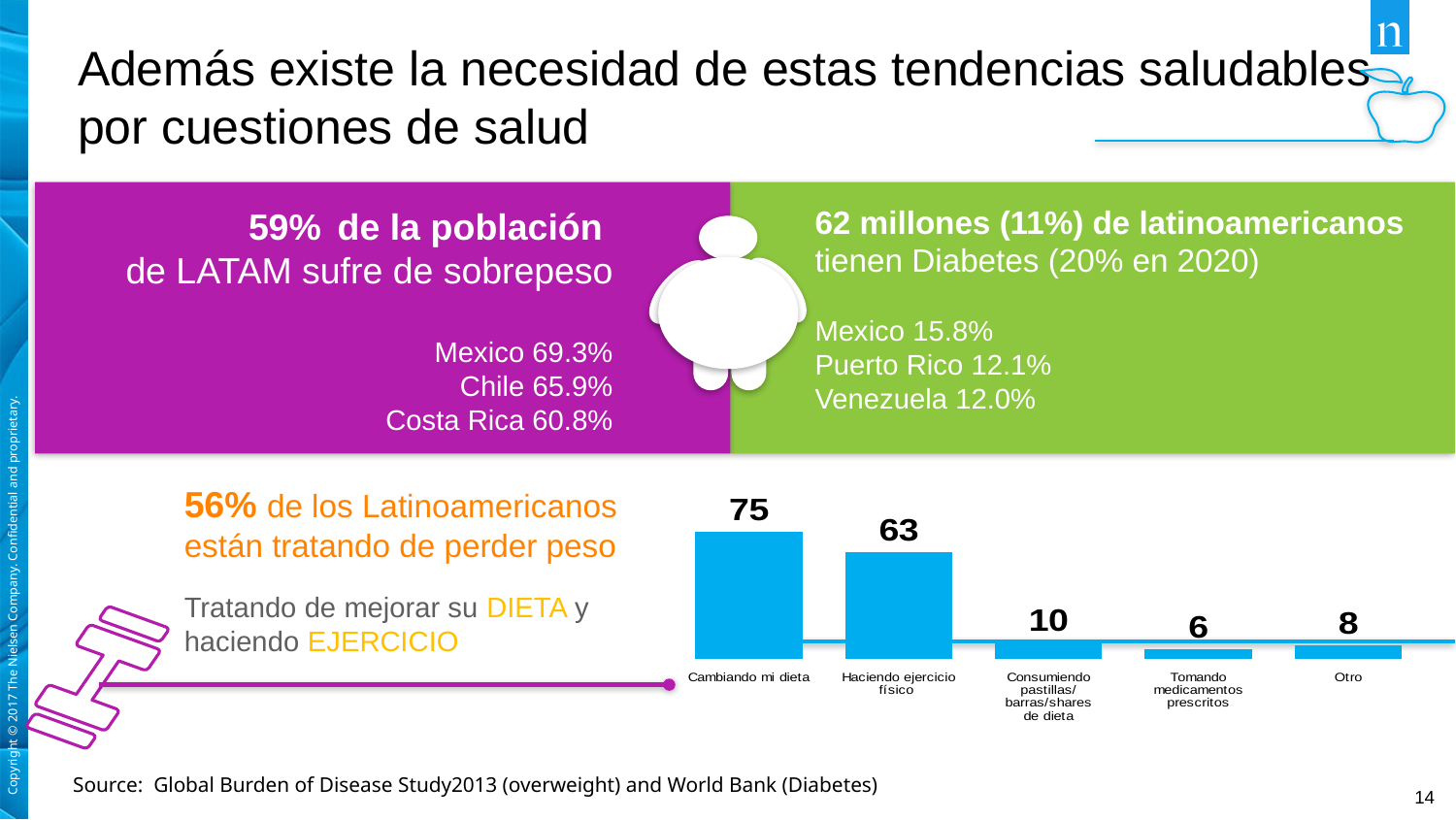
What is the value for "Consumiendo pastillas/barras/shares de dieta" in the bar chart? 10 What is the difference between the values for "Cambiando mi dieta" and "Haciendo ejercicio físico" in the bar chart? 12 What is the value for "Otro" in the bar chart? 8 What is the value for "Haciendo ejercicio físico" in the bar chart? 63 Which category has the lowest value in the bar chart? Tomando medicamentos prescritos Which category has the highest value in the bar chart? Cambiando mi dieta How many categories are shown in the bar chart? 5 What colour are the bars in the chart? Blue What is the value for "Cambiando mi dieta" in the bar chart? 75 What kind of chart is shown on the slide? Bar chart What is the value for "Tomando medicamentos prescritos" in the bar chart? 6 In the bar chart, which is larger: the value for "Otro" or the value for "Tomando medicamentos prescritos"? Otro